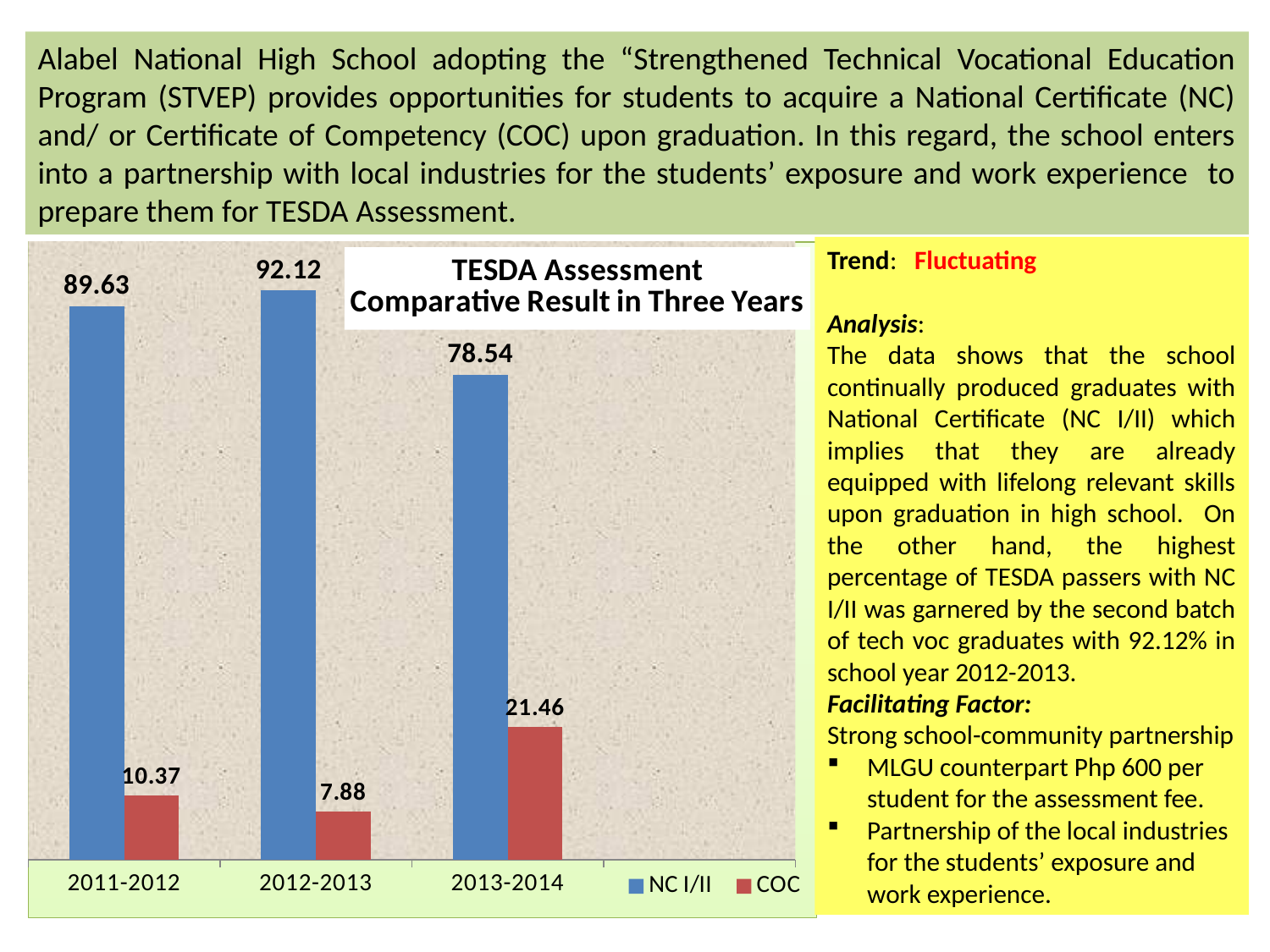
What is the difference between the NC I/II values for 2012-2013 and 2013-2014? 13.58 What kind of chart is shown? bar chart How many school years are shown on the x axis? 3 Which school year has the lowest COC value? 2012-2013 What is the title of the chart? TESDA Assessment Comparative Result in Three Years How many series does the legend list? 2 What is the NC I/II value for 2011-2012? 89.63 Which is larger, the COC value for 2011-2012 or for 2013-2014? 2013-2014 Which school year has the highest NC I/II value? 2012-2013 What is the COC value for 2012-2013? 7.88 What is the COC value for 2013-2014? 21.46 What is the NC I/II value for 2012-2013? 92.12